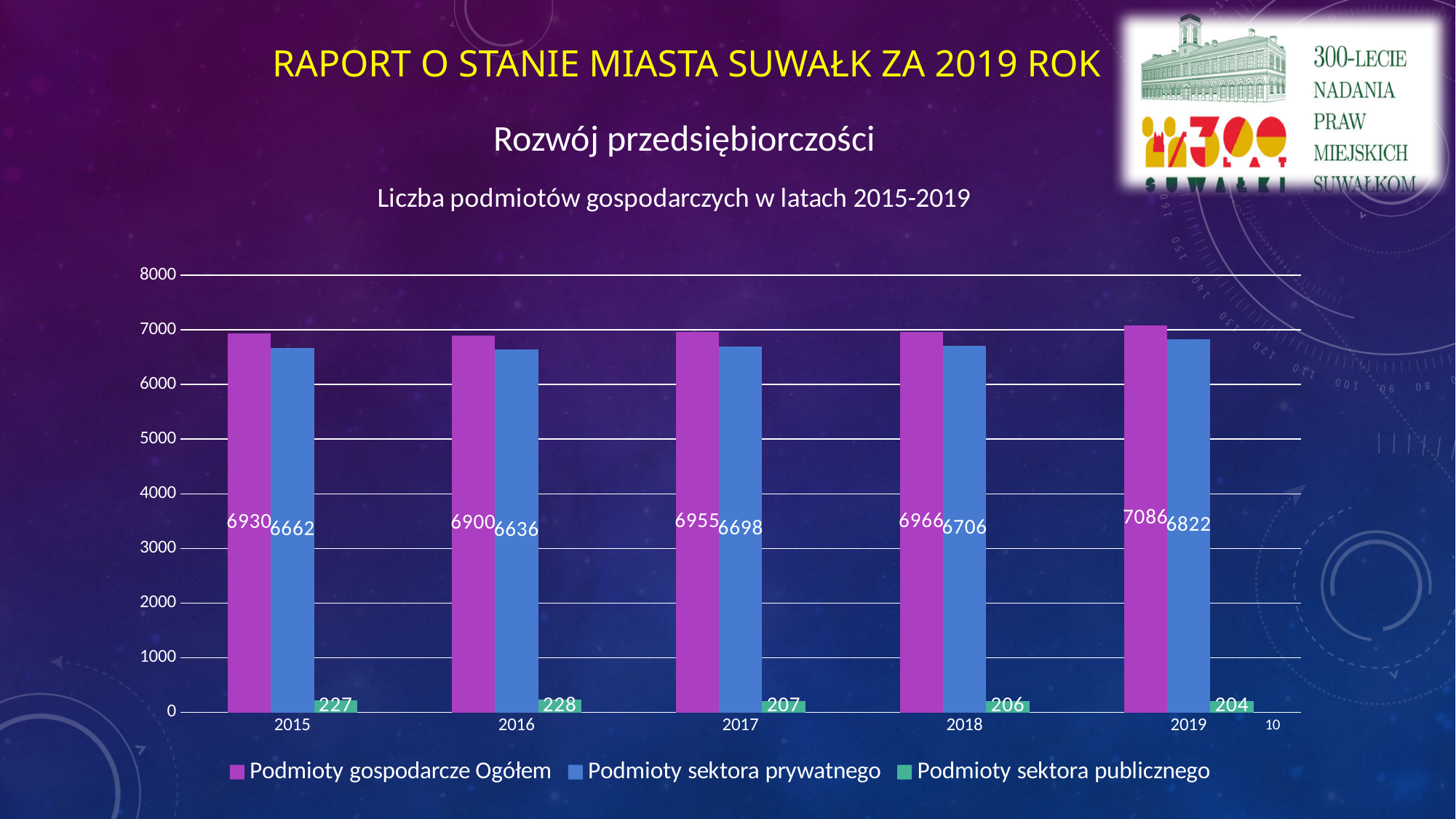
What is the value of Podmioty sektora publicznego in 2017? 207 What is the value of Podmioty sektora prywatnego in 2016? 6636 What is the difference between Podmioty gospodarcze Ogółem and Podmioty sektora prywatnego in 2018? 260 Which is larger: Podmioty sektora publicznego in 2015 or in 2019? 2015 Is the value for Podmioty sektora prywatnego in 2019 greater or less than 6000? greater In which year is Podmioty sektora publicznego the lowest? 2019 What is the value of Podmioty gospodarcze Ogółem in 2019? 7086 In which year is Podmioty gospodarcze Ogółem the highest? 2019 How many series does the legend list? 3 What is the title of the chart? Liczba podmiotów gospodarczych w latach 2015-2019 How many years are shown on the x axis? 5 What kind of chart is shown on the slide? bar chart